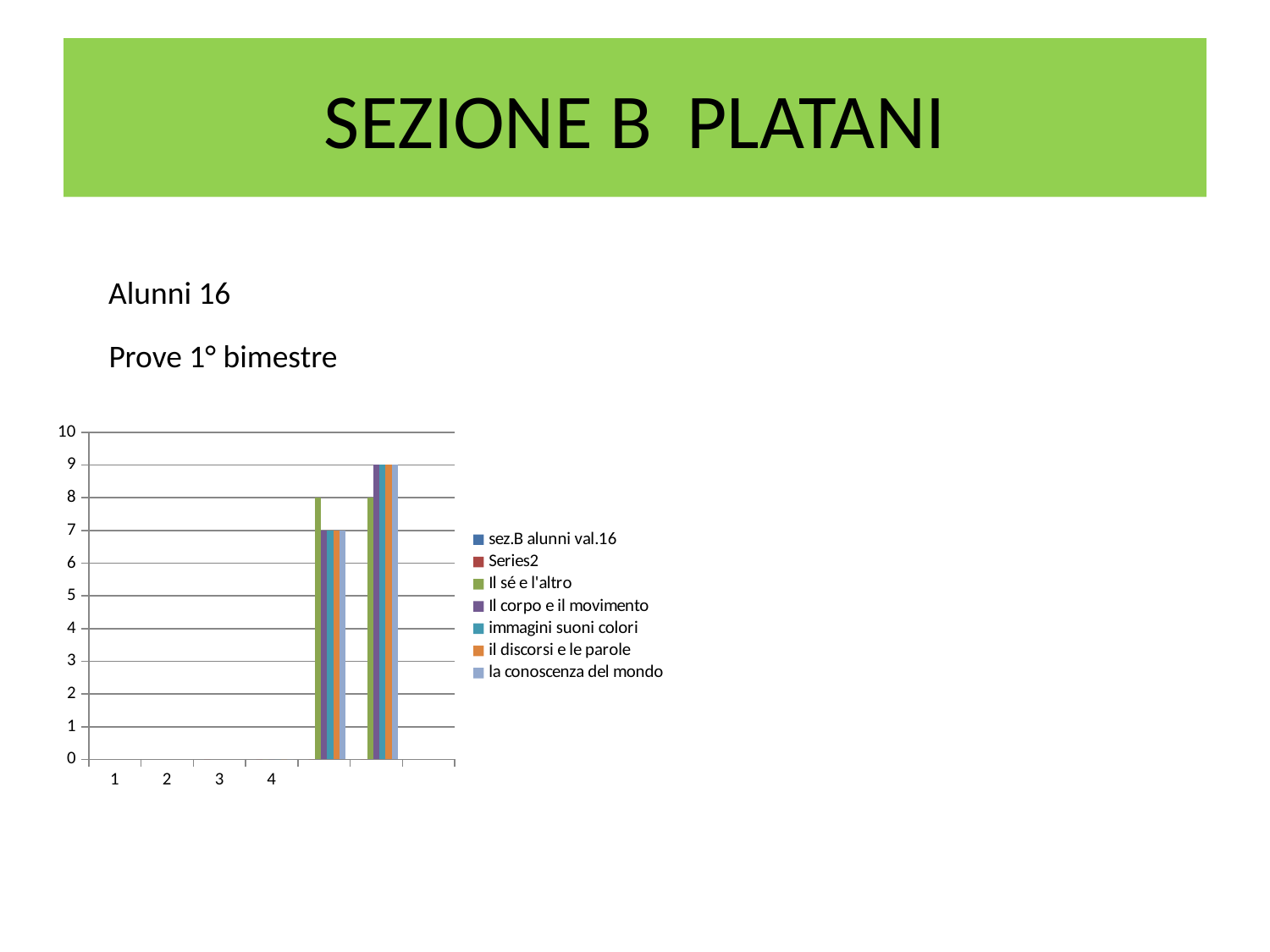
What is the highest value shown on the chart's vertical axis? 10 What is the highest value reached by any bar in the chart? 9 Is the tallest bar in the chart greater or less than 5? greater What kind of chart is shown on the slide? bar chart How many series does the chart legend list? 7 In the chart, is the tallest bar greater or less than 10? less What is the first entry listed in the chart legend? sez.B alunni val.16 Are all the plotted bars in the chart greater or less than 5? greater